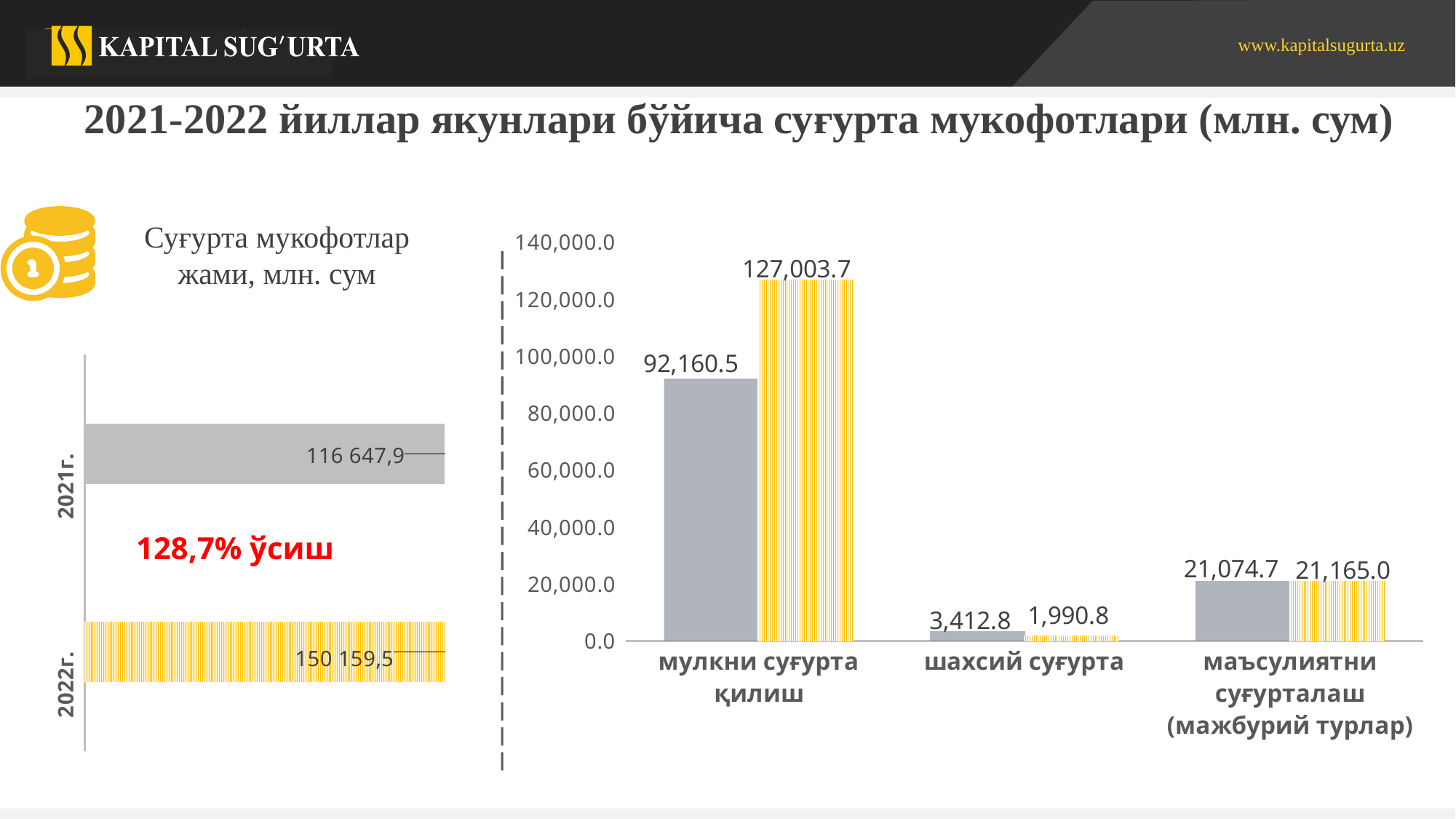
In the right chart, what is the value of the yellow striped bar for 'маъсулиятни суғурталаш (мажбурий турлар)'? 21,165.0 In the right chart, which category has the highest value overall? мулкни суғурта қилиш In the left chart titled 'Суғурта мукофотлар жами, млн. сум', what is the value for 2021г.? 116 647,9 In the right chart, what is the difference between the yellow striped bar and the grey bar for 'мулкни суғурта қилиш'? 34,843.2 In the left chart titled 'Суғурта мукофотлар жами, млн. сум', which year has the larger value, 2021г. or 2022г.? 2022г. In the left chart titled 'Суғурта мукофотлар жами, млн. сум', what is the value for 2022г.? 150 159,5 In the right chart, what is the value of the grey bar for 'шахсий суғурта'? 3,412.8 In the right chart, what is the value of the yellow striped bar for 'мулкни суғурта қилиш'? 127,003.7 In the right chart, what is the value of the grey bar for 'мулкни суғурта қилиш'? 92,160.5 In the left chart titled 'Суғурта мукофотлар жами, млн. сум', what growth percentage is printed in red between the bars? 128,7% ўсиш What kind of chart is the right chart? Bar chart In the right chart, how many categories are shown on the x axis? 3